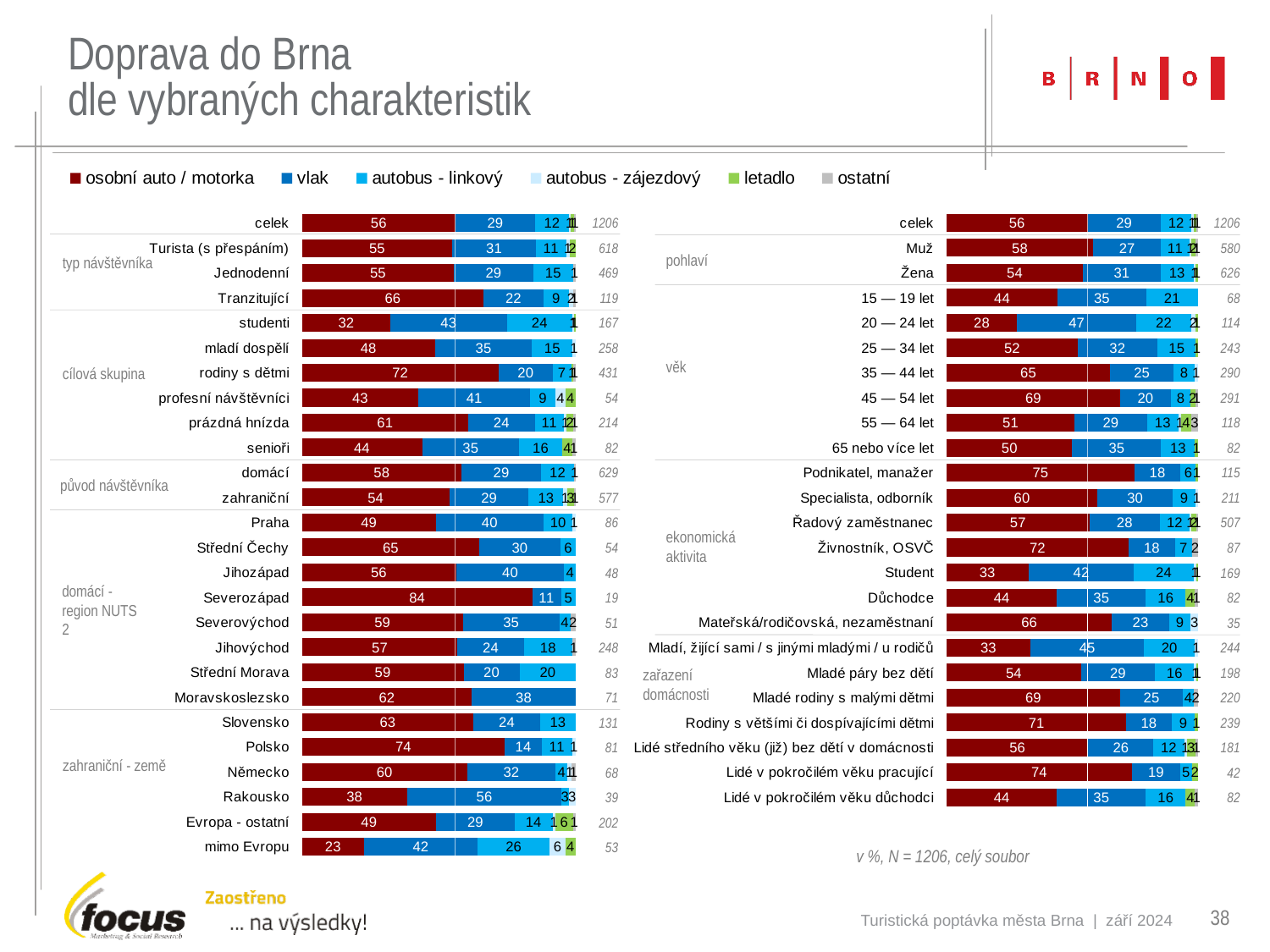
In the left chart, what is the difference between the osobní auto / motorka value for Tranzitující and for celek? 10 In the left chart, what is the value for osobní auto / motorka for Severozápad? 84 In the left chart, which category has the lowest value for osobní auto / motorka? mimo Evropu In the right chart, what is the value for osobní auto / motorka for Podnikatel, manažer? 75 What kind of chart is shown on the slide? Stacked bar chart In the right chart, what is the value for autobus - linkový for Student? 24 In the left chart, what is the value for vlak for Rakousko? 56 How many series does the legend list? 6 In the left chart, which has the larger value for vlak, studenti or rodiny s dětmi? studenti In the left chart, which category has the highest value for osobní auto / motorka? Severozápad In the right chart, what is the value for vlak for 20 — 24 let? 47 In the right chart, which has the larger value for osobní auto / motorka, Muž or Žena? Muž